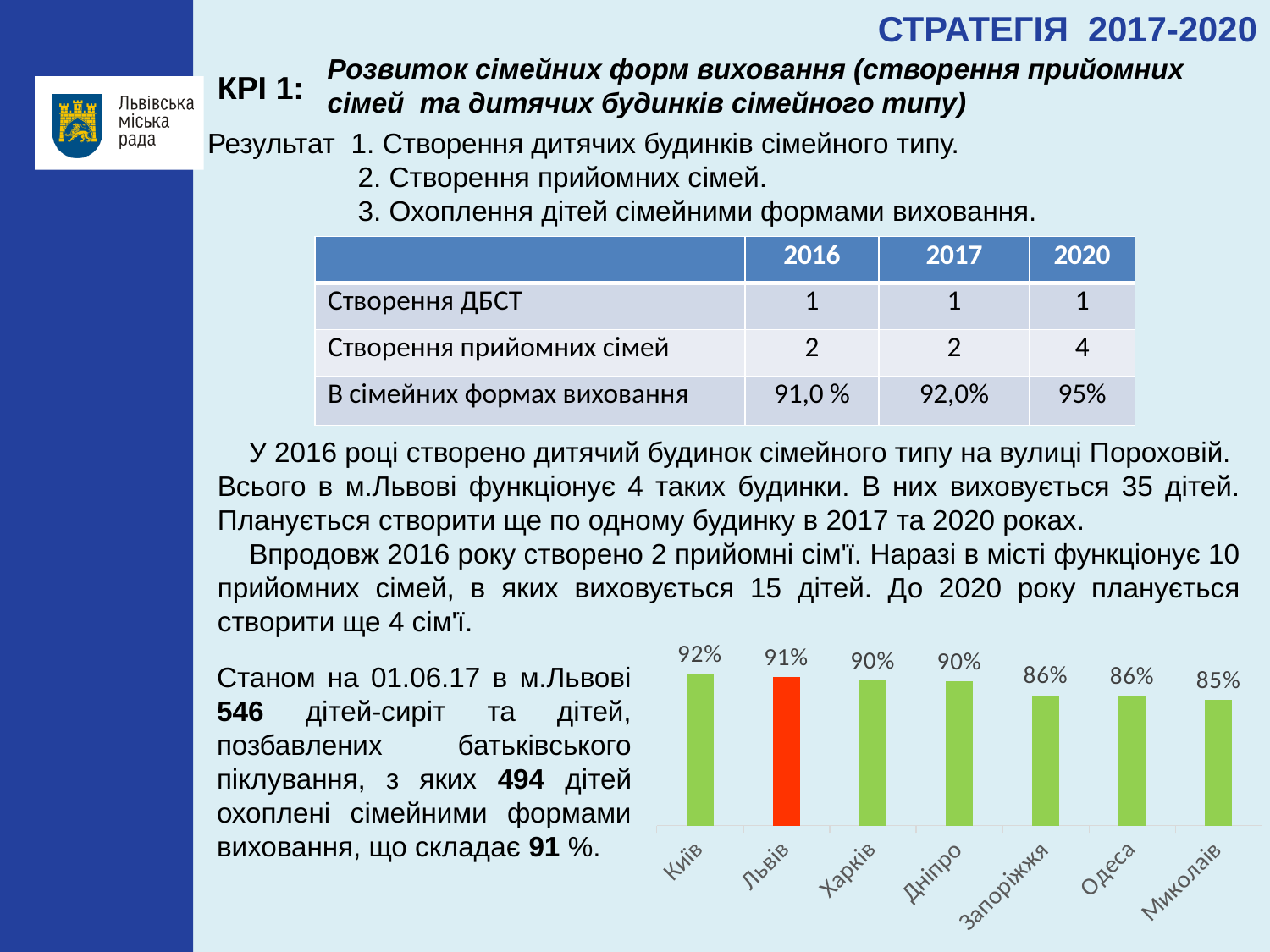
How many cities are shown in the bar chart? 7 What is the value for Київ in the bar chart? 92% Which has a larger value in the bar chart, Харків or Одеса? Харків What is the value for Львів in the bar chart? 91% Which city has the highest value in the bar chart? Київ What is the value for Миколаїв in the bar chart? 85% What kind of chart is shown at the bottom right of the slide? Bar chart What is the value for Запоріжжя in the bar chart? 86% What is the difference between the values for Київ and Миколаїв in the bar chart? 7% What is the difference between the values for Львів and Одеса in the bar chart? 5% Which city has the lowest value in the bar chart? Миколаїв Which city's bar is coloured red in the bar chart? Львів